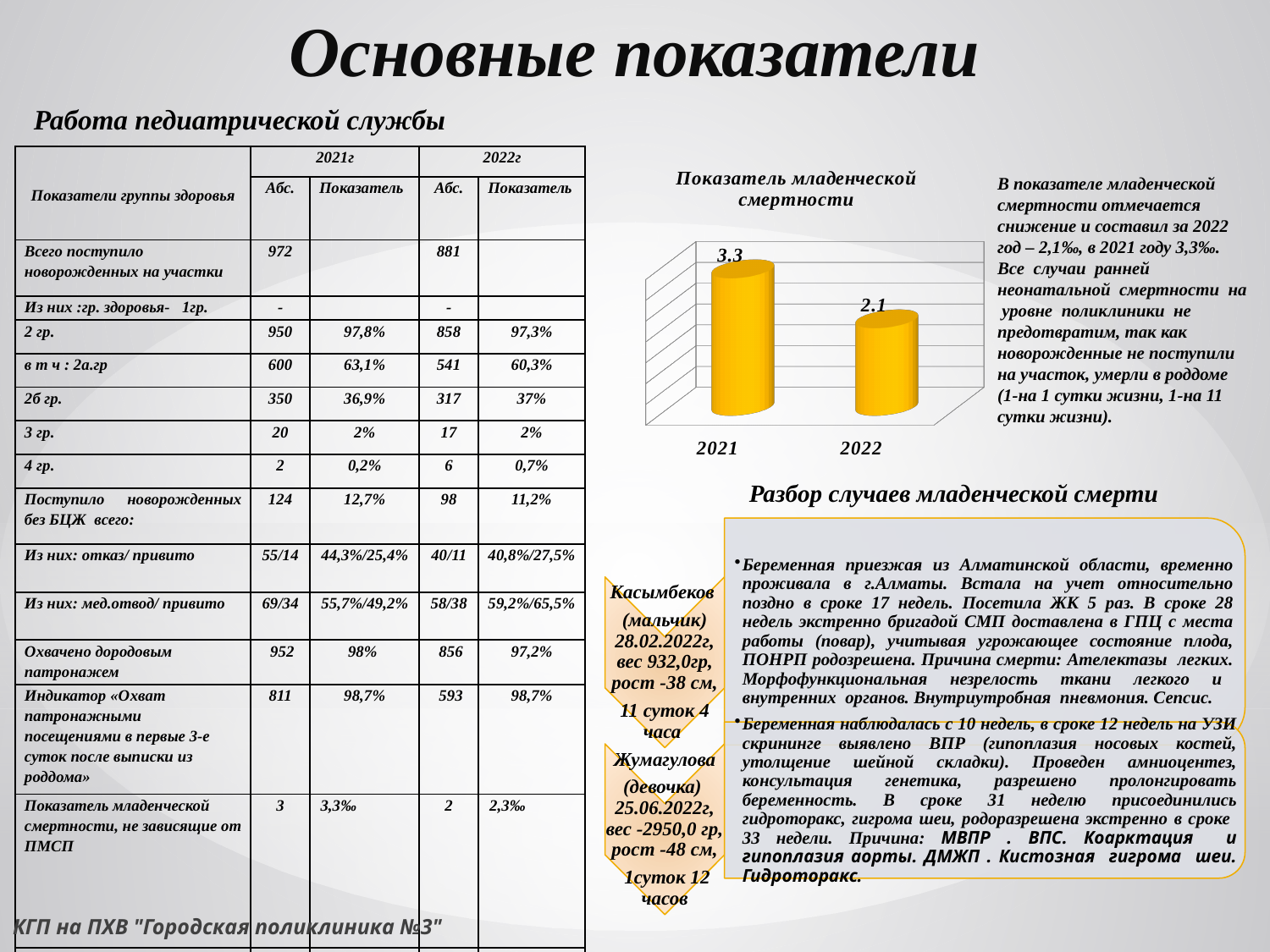
What kind of chart is 'Показатель младенческой смертности'? bar chart Which year has the highest value in the chart 'Показатель младенческой смертности'? 2021 What is the difference between the 2021 and 2022 values in the chart 'Показатель младенческой смертности'? 1.2 What colour are the bars in the chart 'Показатель младенческой смертности'? yellow/orange Do the values in the chart 'Показатель младенческой смертности' rise or fall from 2021 to 2022? fall What is the title of the chart on the slide? Показатель младенческой смертности What is the value for 2022 in the chart 'Показатель младенческой смертности'? 2.1 How many categories (years) are shown in the chart 'Показатель младенческой смертности'? 2 Which year has the lowest value in the chart 'Показатель младенческой смертности'? 2022 What is the value for 2021 in the chart 'Показатель младенческой смертности'? 3.3 In the chart 'Показатель младенческой смертности', is the value for 2021 larger or smaller than the value for 2022? larger